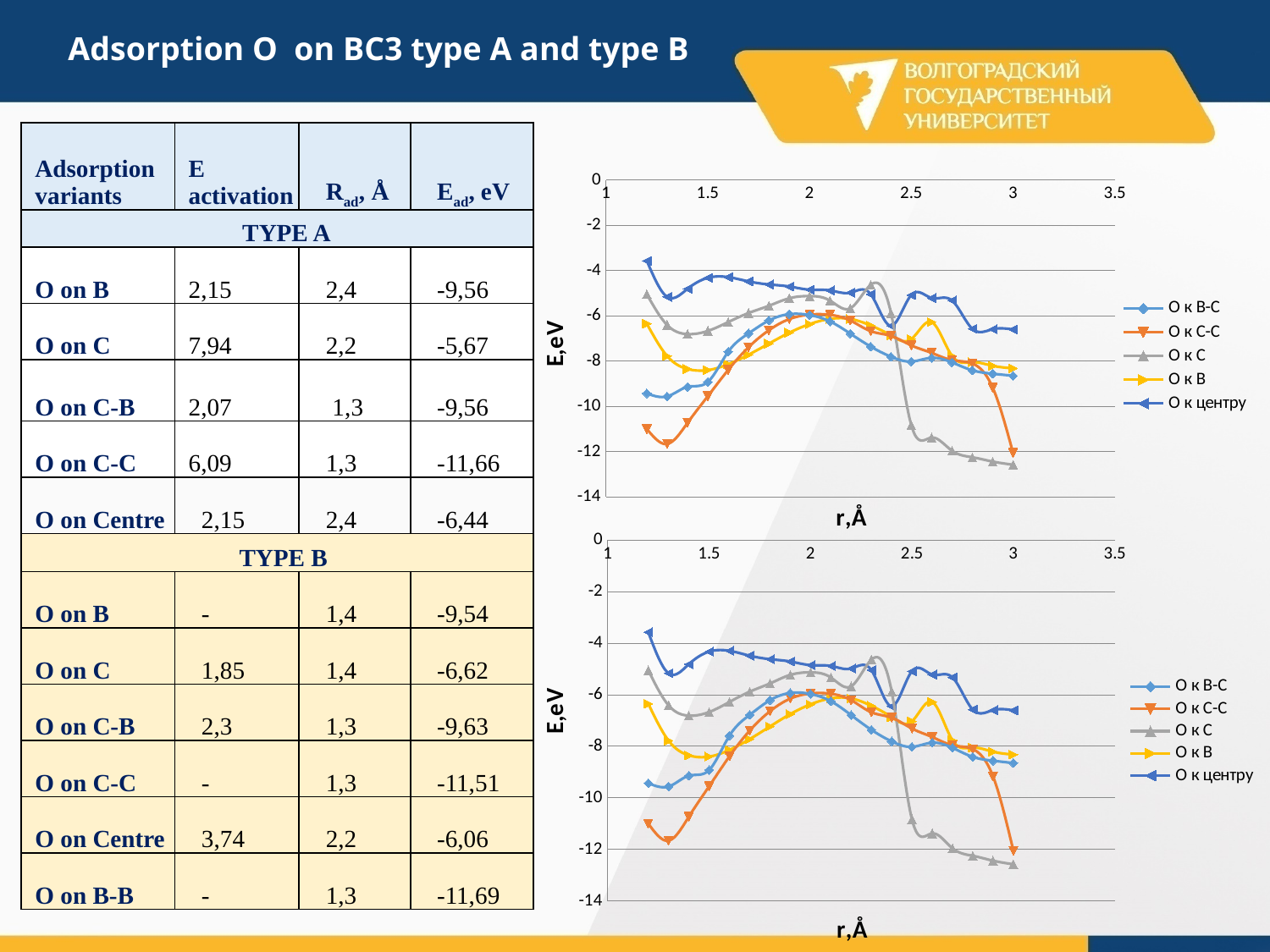
How many series does the legend of the bottom chart list? 5 What kind of chart is the top chart on the right of the slide? line chart How many series does the legend of the top chart list? 5 In the top chart, is the value of the 'О к C' series at r = 3 greater or less than -10? less In the top chart, which series has the highest value at r = 1.5? О к центру In the bottom chart, does the 'О к C-C' series rise or fall as r increases from 1.3 to 2? rise In the bottom chart, is the value of the 'О к C-C' series at r = 1.3 greater or less than -10? less In the top chart, does the 'О к C' series rise or fall as r increases from 2.3 to 3? fall In the top chart, what is the label of the vertical axis? E,eV In the bottom chart, is the value of the 'О к B-C' series at r = 1.2 greater or less than -8? less In the bottom chart, what is the label of the horizontal axis? r,Å